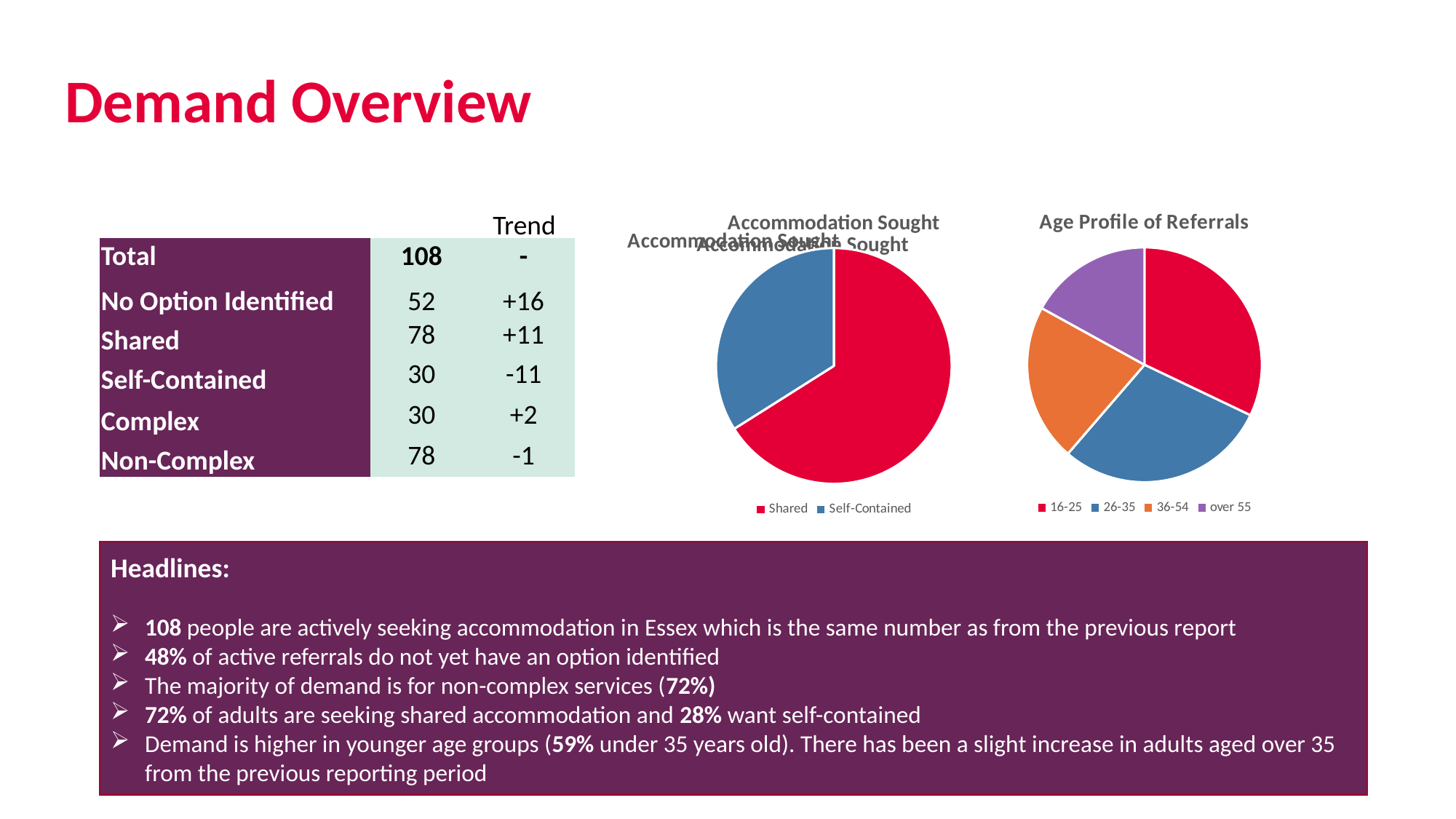
In the Age Profile of Referrals chart, which age group has the smallest slice? over 55 In the Age Profile of Referrals chart, how many age groups does the legend list? 4 In the Accommodation Sought chart, which category has the smallest slice? Self-Contained What kind of chart is the Age Profile of Referrals chart? pie chart In the Age Profile of Referrals chart, which slice is larger: 36-54 or over 55? 36-54 In the Age Profile of Referrals chart, which age group has the largest slice? 16-25 In the Accommodation Sought chart, which category has the largest slice? Shared In the Accommodation Sought chart, how many categories does the legend list? 2 In the Age Profile of Referrals chart, what colour is the over 55 slice? purple What kind of chart is the Accommodation Sought chart? pie chart What is the title of the pie chart on the right of the slide? Age Profile of Referrals In the Accommodation Sought chart, which slice is larger: Shared or Self-Contained? Shared